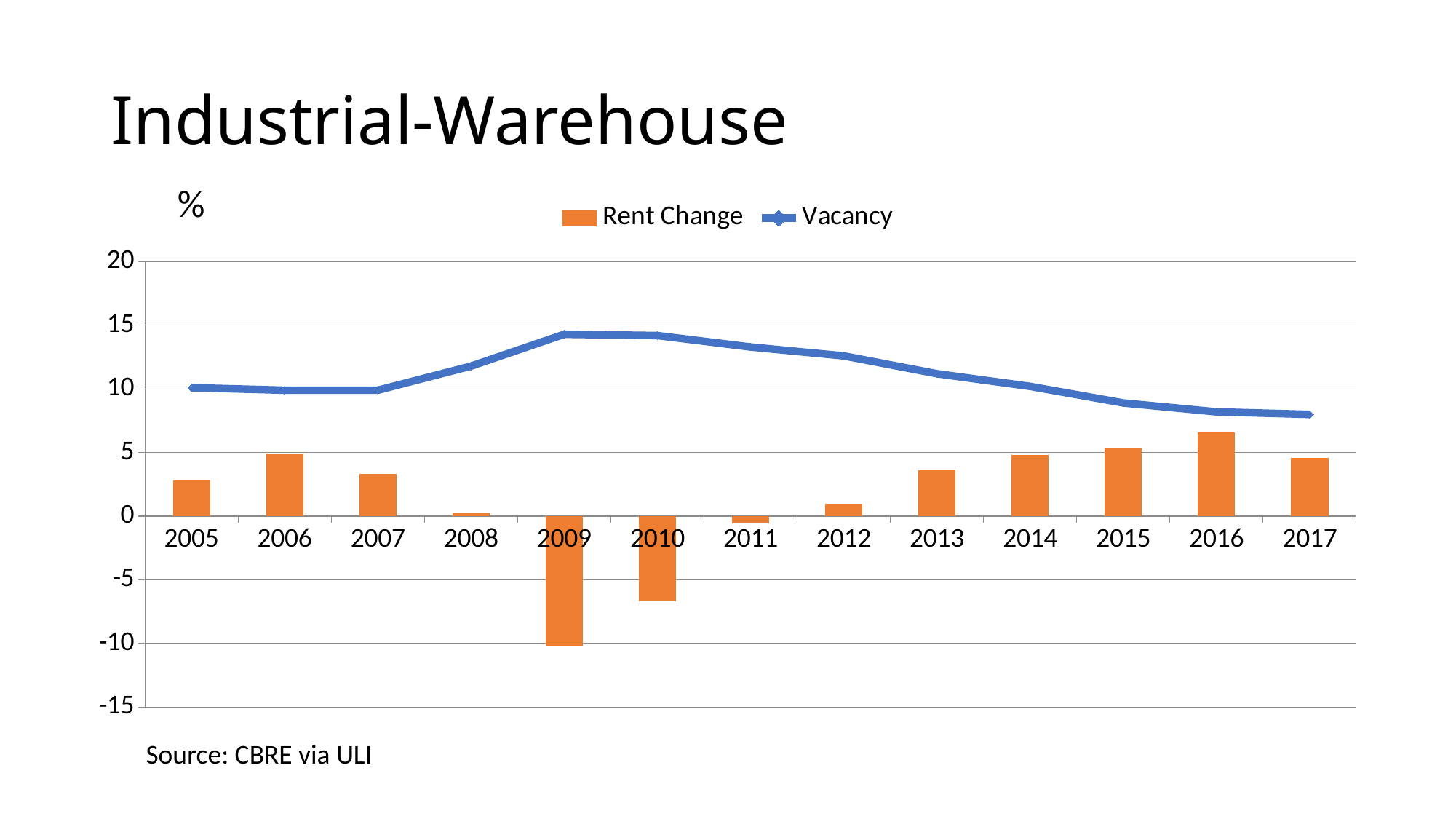
What colour is the Vacancy line? Blue How many series does the legend list? 2 Which year has the larger Rent Change, 2006 or 2007? 2006 How many years are shown on the x axis? 13 Is the Vacancy value for 2009 greater or less than 10? greater In which year is Rent Change highest? 2016 What kind of chart is shown on the slide? A combination bar and line chart Is the Rent Change value for 2010 greater or less than -5? less Is the Rent Change value for 2016 greater or less than 5? greater In which year is Rent Change lowest? 2009 Does Vacancy rise or fall from 2010 to 2017? It falls